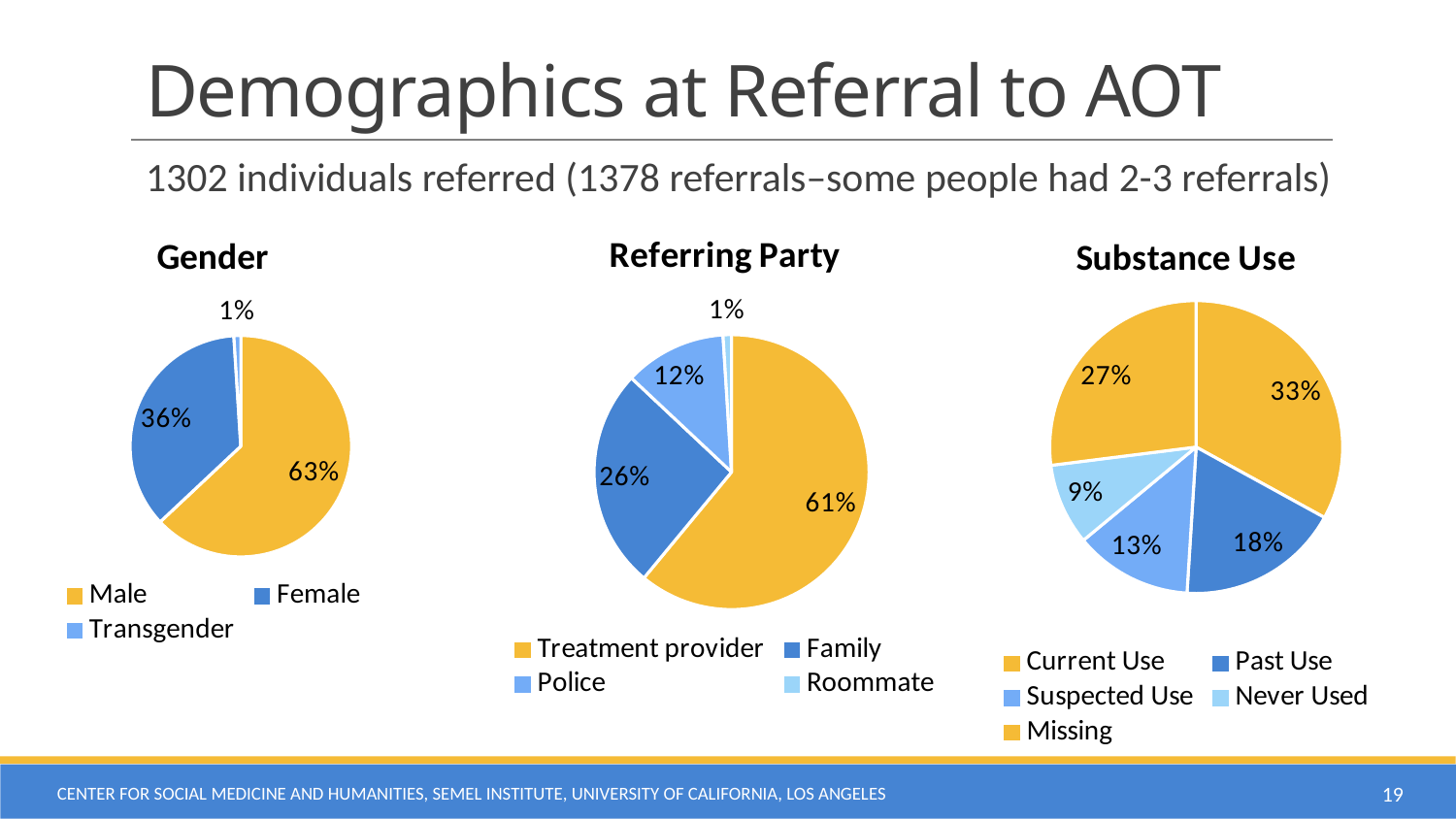
In the Referring Party pie chart, what is the difference between the Family and Police shares? 14% What type of chart is used for Gender, Referring Party and Substance Use? Pie chart In the Substance Use pie chart, which is larger, Current Use or Missing? Current Use In the Referring Party pie chart, which category has the largest share? Treatment provider In the Referring Party pie chart, how many categories does the legend list? 4 In the Substance Use pie chart, what share is Past Use? 18% In the Gender pie chart, what share is Male? 63% In the Gender pie chart, which category has the smallest share? Transgender In the Substance Use pie chart, how many categories does the legend list? 5 In the Referring Party pie chart, what share is Family? 26% In the Gender pie chart, what share is Female? 36% In the Substance Use pie chart, which category has the smallest share? Never Used